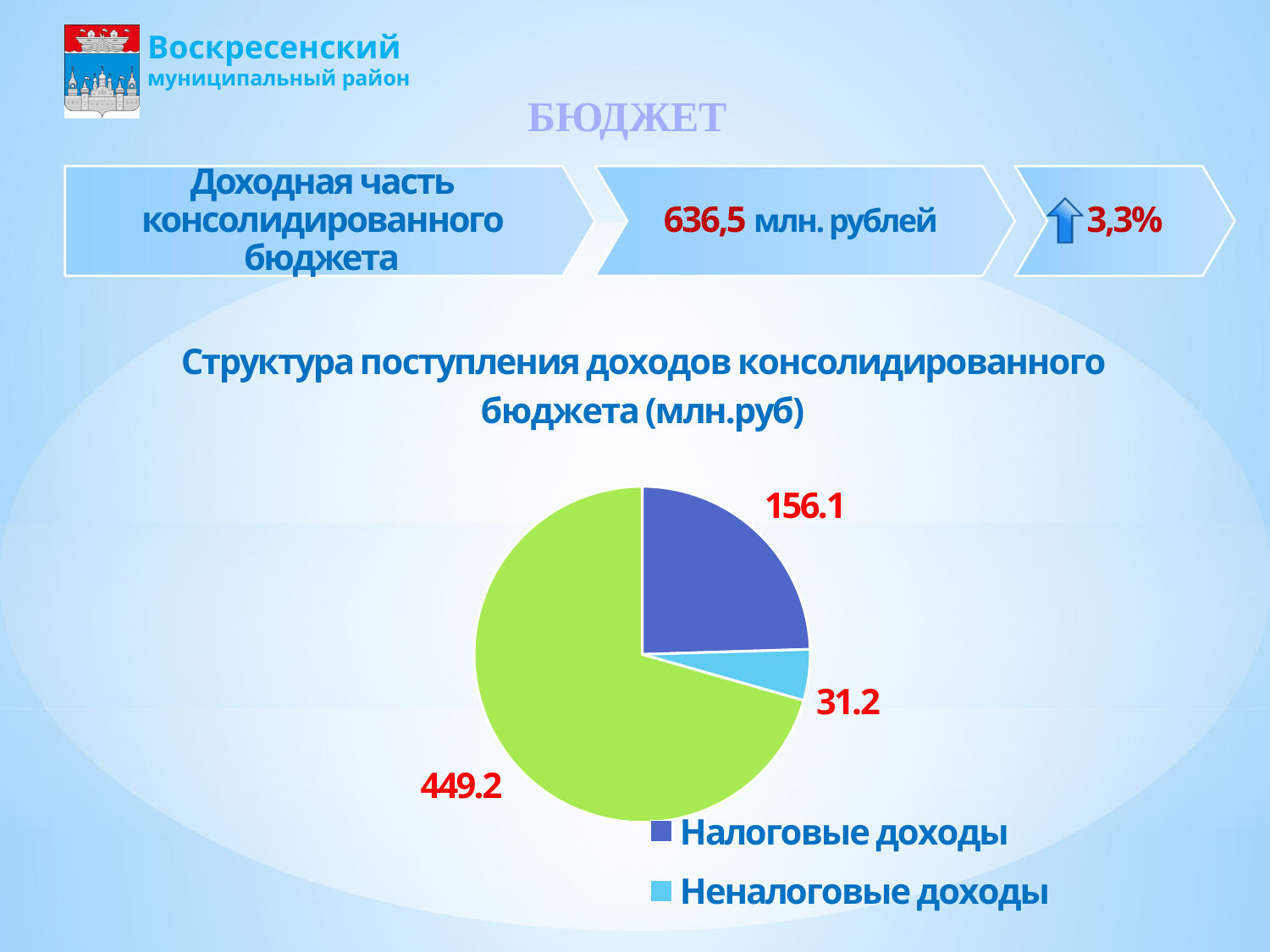
What is the title of the pie chart? Структура поступления доходов консолидированного бюджета (млн.руб) What is the value for Налоговые доходы in the pie chart? 156.1 Which is larger in the pie chart, Налоговые доходы or Неналоговые доходы? Налоговые доходы What is the value for Неналоговые доходы in the pie chart? 31.2 What is the value of the largest slice in the pie chart? 449.2 What kind of chart is shown on the slide? pie chart How many slices does the pie chart have? 3 What is the difference between Налоговые доходы and Неналоговые доходы in the pie chart? 124.9 What colour is the slice for Неналоговые доходы in the pie chart? light blue What is the total of all slices in the pie chart? 636.5 How many entries does the legend of the pie chart list? 2 Which legend category has the smallest slice in the pie chart? Неналоговые доходы